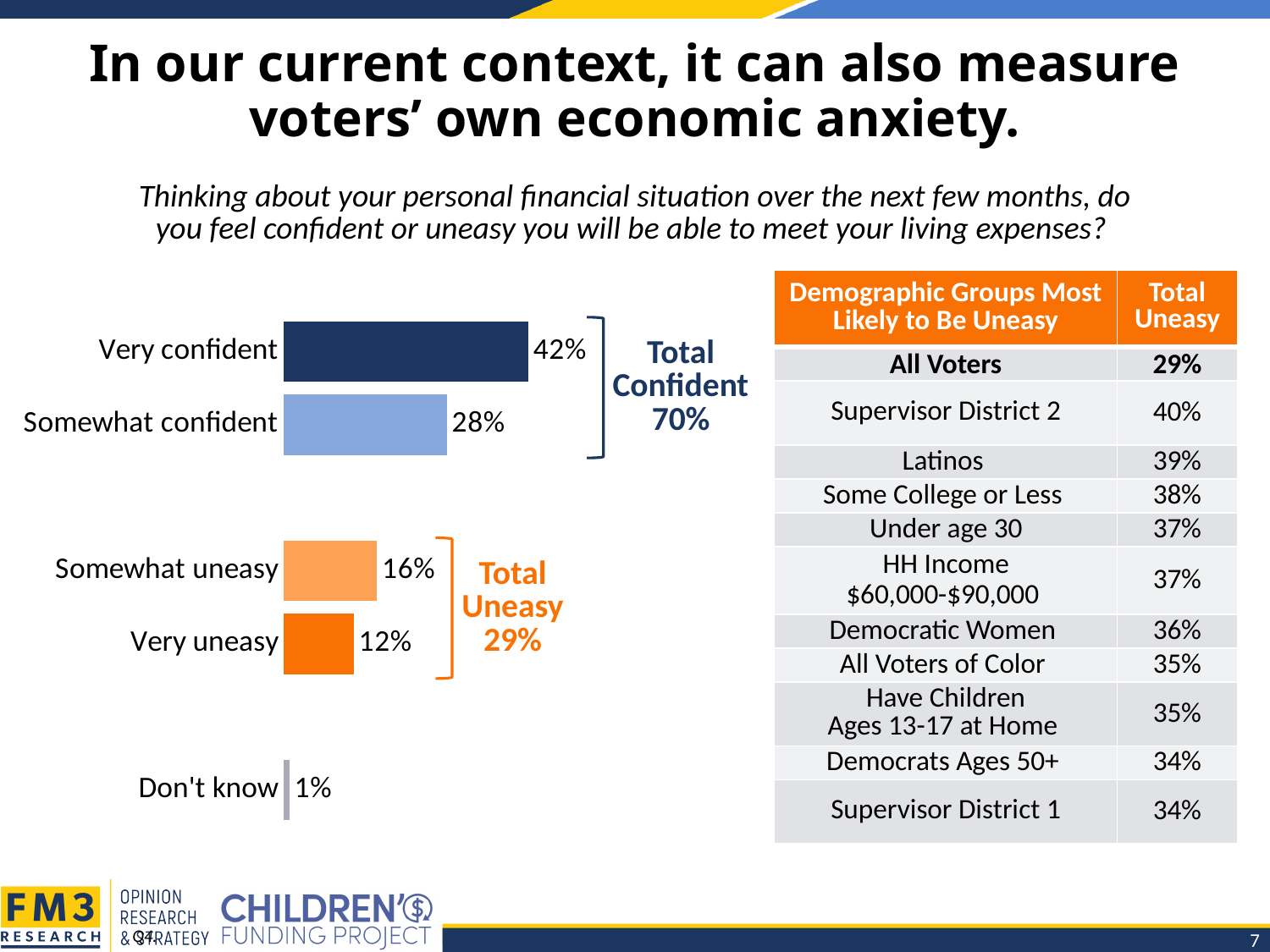
What is the Total Uneasy percentage shown next to the bar chart? 29% How many response categories are shown in the bar chart? 5 What percentage of voters said they are very uneasy? 12% Which response category has the highest percentage? Very confident What percentage of voters said they are somewhat confident? 28% What percentage of voters said they are very confident? 42% What percentage of voters answered "Don't know"? 1% What type of chart is used to show the responses? Bar chart Which response category has the lowest percentage? Don't know What is the difference between the percentage for very confident and the percentage for somewhat confident? 14 percentage points Which is larger, the percentage for somewhat uneasy or the percentage for very uneasy? Somewhat uneasy What percentage of voters said they are somewhat uneasy? 16%